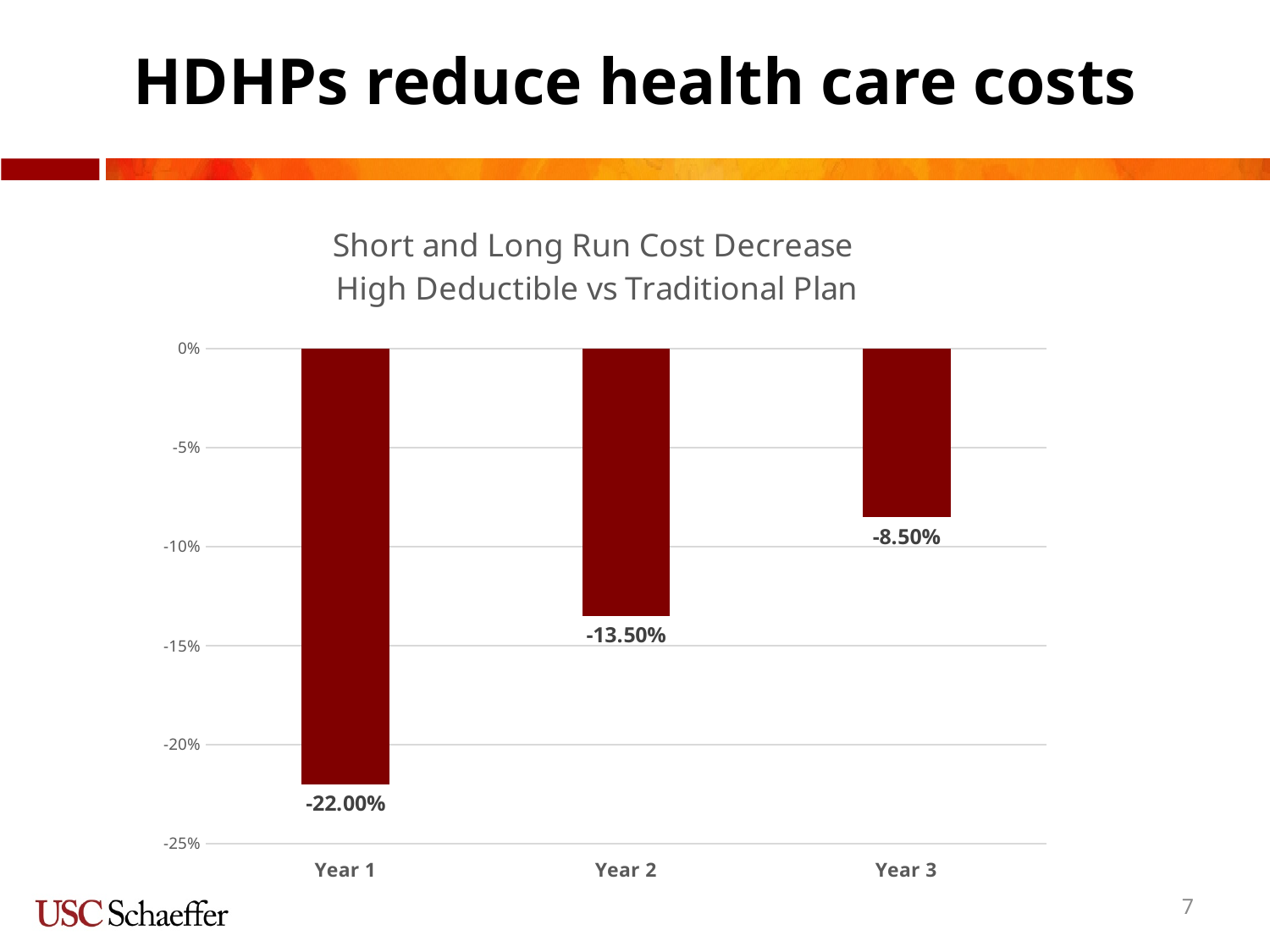
What is the difference between the Year 1 and Year 2 values? 8.50% How many years are shown on the chart? 3 What is the difference between the Year 2 and Year 3 values? 5.00% What is the value for Year 1? -22.00% Is the value for Year 2 greater or less than -10%? less What is the value for Year 3? -8.50% Which year has the highest (least negative) value? Year 3 Which year has the lowest (most negative) value? Year 1 What is the title of the chart? Short and Long Run Cost Decrease High Deductible vs Traditional Plan What kind of chart is shown on the slide? Bar chart What is the value for Year 2? -13.50% Which is larger in magnitude, the cost decrease in Year 1 or in Year 3? Year 1